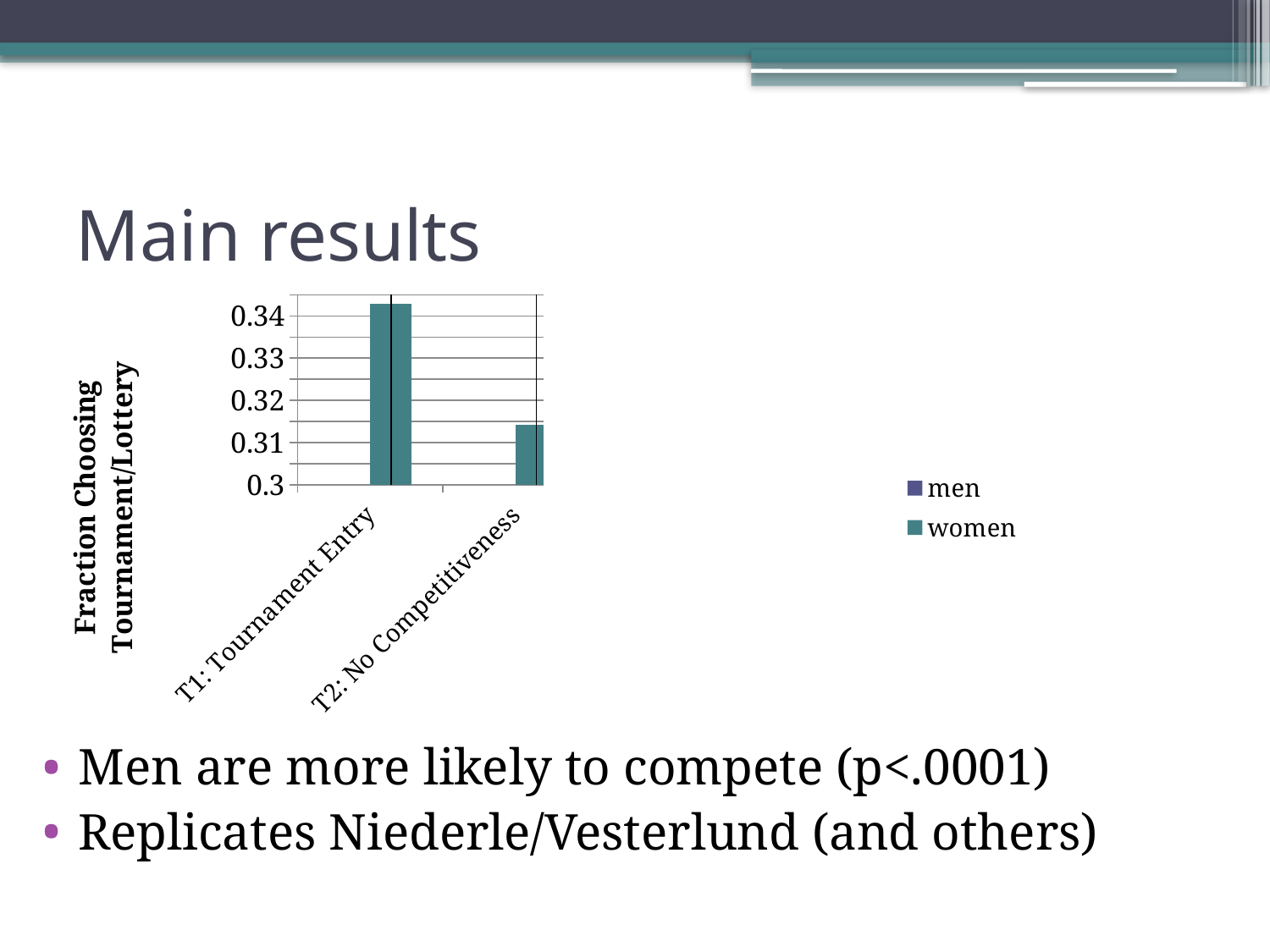
How many categories are shown on the x axis of the chart? 2 What kind of chart is shown on the slide? bar chart Do the women values rise or fall from T1: Tournament Entry to T2: No Competitiveness? fall Which category has the higher value for women: T1: Tournament Entry or T2: No Competitiveness? T1: Tournament Entry How many series does the chart's legend list? 2 In which category is the women bar the lowest? T2: No Competitiveness Is the value for women in T1: Tournament Entry greater or less than 0.33? greater What is the label on the vertical axis of the chart? Fraction Choosing Tournament/Lottery What is the lowest value shown on the vertical axis of the chart? 0.3 What are the two series named in the chart's legend? men and women Is the value for women in T2: No Competitiveness greater or less than 0.32? less Is the value for women in T2: No Competitiveness greater or less than 0.31? greater